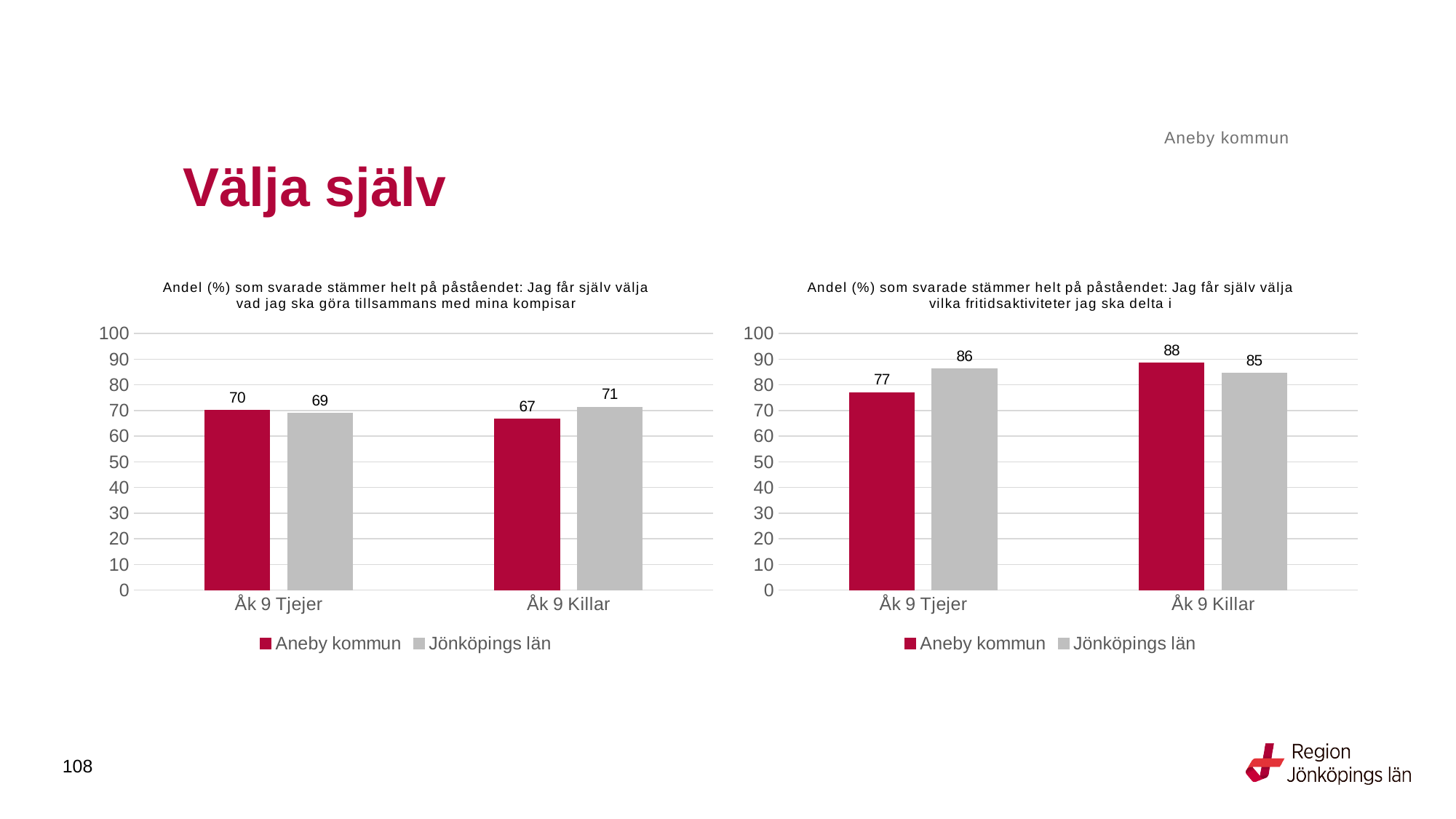
In the left chart (about choosing what to do with friends), which bar has the lowest value? Aneby kommun, Åk 9 Killar In the right chart (about choosing leisure activities), which is larger for Åk 9 Killar: Aneby kommun or Jönköpings län? Aneby kommun How many categories are shown on the x axis of the left chart? 2 In the right chart (about choosing leisure activities), what is the value for Jönköpings län for Åk 9 Tjejer? 86 In the left chart (about choosing what to do with friends), what is the value for Jönköpings län for Åk 9 Killar? 71 In the right chart (about choosing leisure activities), what is the difference between Jönköpings län and Aneby kommun for Åk 9 Tjejer? 9 In the left chart (about choosing what to do with friends), what is the value for Aneby kommun for Åk 9 Tjejer? 70 In the right chart (about choosing leisure activities), what is the value for Aneby kommun for Åk 9 Killar? 88 In the right chart (about choosing leisure activities), which bar has the highest value? Aneby kommun, Åk 9 Killar How many series does the legend of the left chart list? 2 What kind of chart is the right chart (about choosing leisure activities)? Bar chart In the left chart (about choosing what to do with friends), what is the difference between Jönköpings län and Aneby kommun for Åk 9 Killar? 4